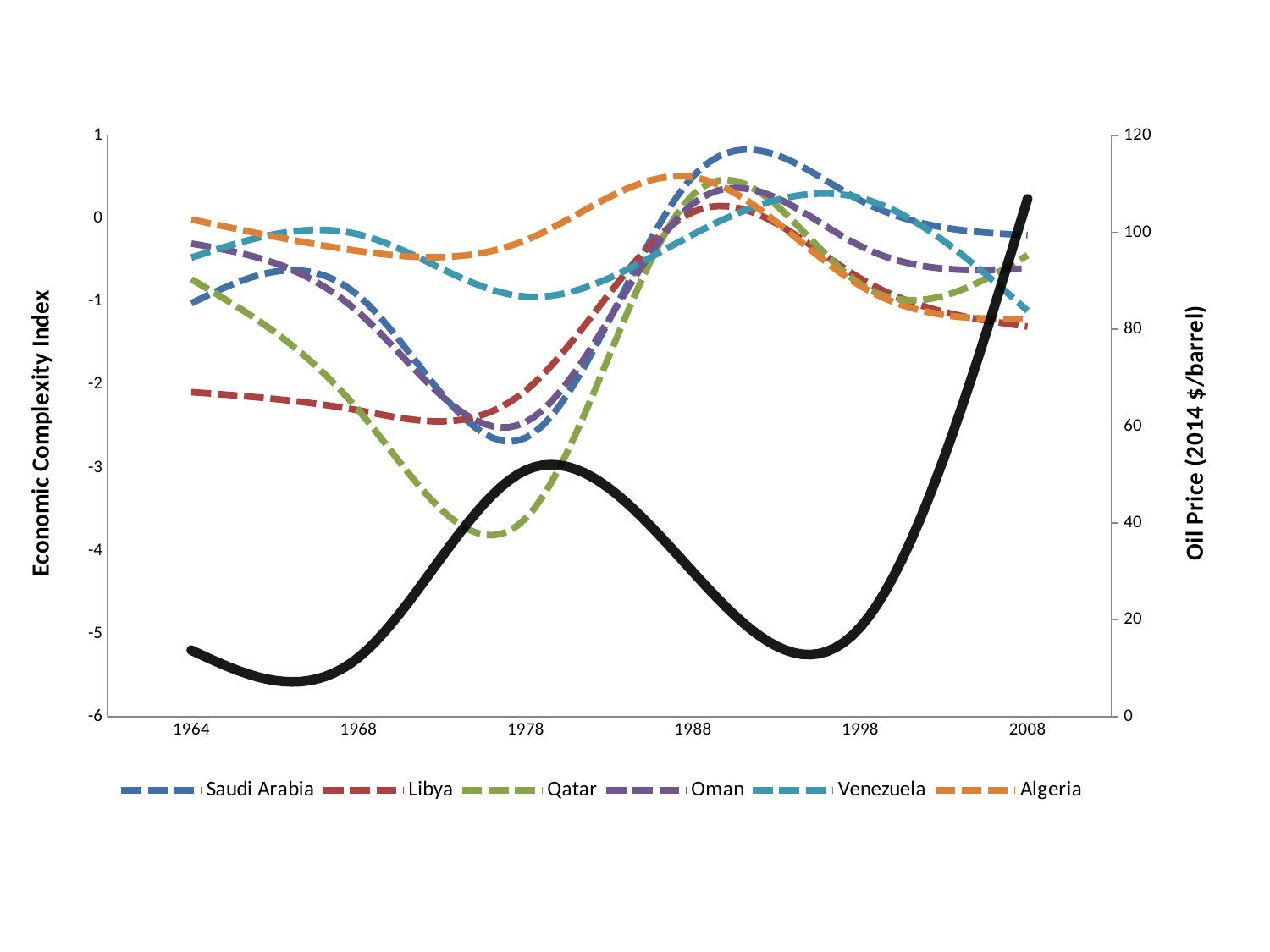
What is the title of the right vertical axis? Oil Price (2014 $/barrel) Does the oil price line rise or fall between 1998 and 2008? Rise Which country has the lowest Economic Complexity Index in 1964? Libya How many series does the legend list? 6 How many year labels are shown on the x axis? 6 Is the oil price value in 1998 greater or less than 20? less What kind of chart is shown on the slide? Line chart In 1964, which has the higher Economic Complexity Index, Saudi Arabia or Libya? Saudi Arabia Which country has the lowest Economic Complexity Index in 1978? Qatar Is the Economic Complexity Index value for Qatar in 1978 greater or less than -3? less Is the oil price value in 2008 greater or less than 100? greater What is the title of the left vertical axis? Economic Complexity Index